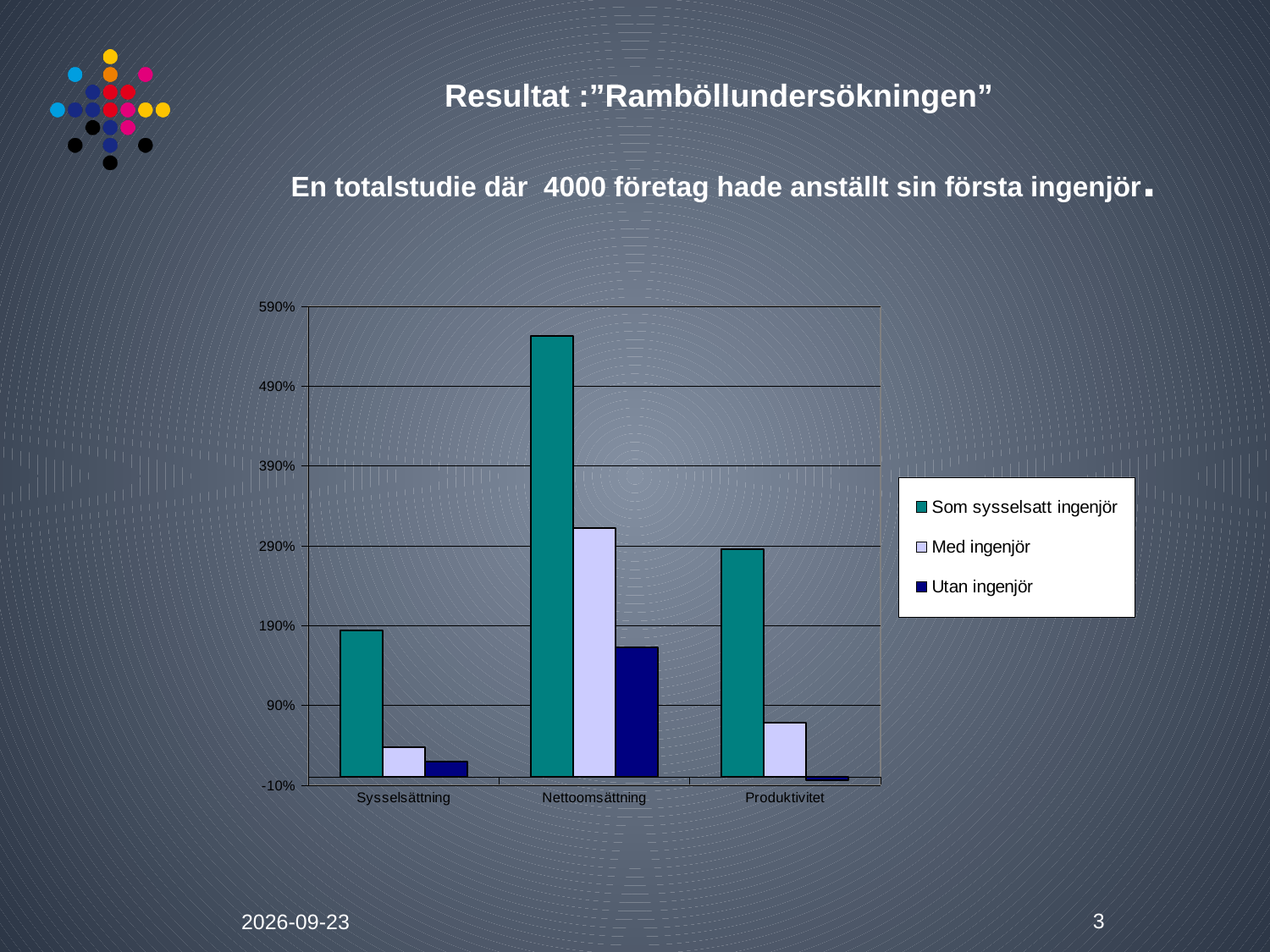
How many series does the chart's legend list? 3 Is the value for 'Som sysselsatt ingenjör' in Nettoomsättning greater or less than 490%? greater Is the value for 'Som sysselsatt ingenjör' in Produktivitet greater or less than 190%? greater For the series 'Utan ingenjör', which category has the lowest value? Produktivitet What colour represents the series 'Utan ingenjör' in the chart? dark blue Which category has the highest value for the series 'Med ingenjör'? Nettoomsättning What kind of chart is shown on the slide? bar chart Is the value for 'Med ingenjör' in Nettoomsättning greater or less than 290%? greater For the series 'Som sysselsatt ingenjör', which category has the highest value? Nettoomsättning How many categories are shown on the x axis of the chart? 3 In the Sysselsättning category, which is larger: 'Med ingenjör' or 'Utan ingenjör'? Med ingenjör